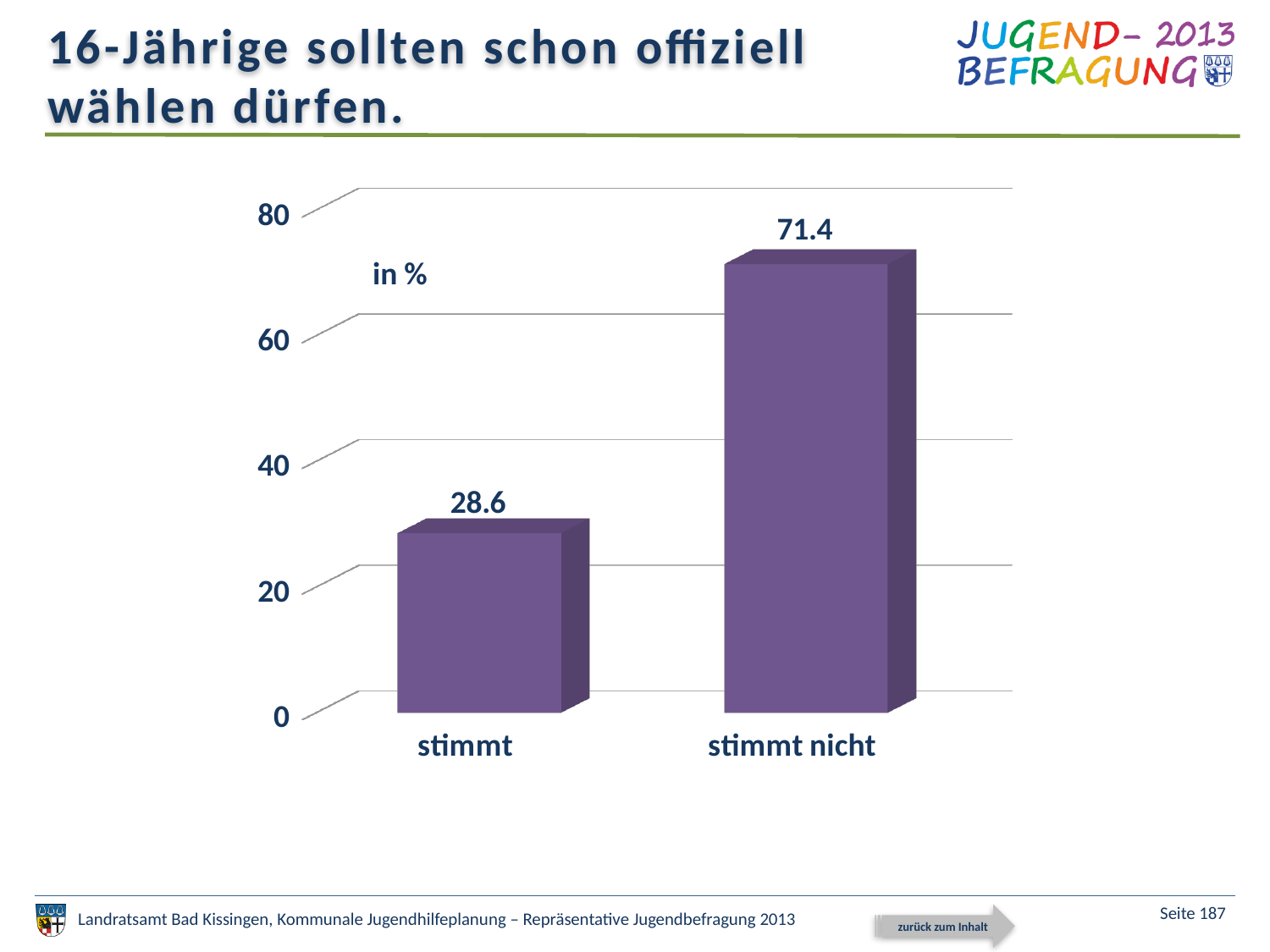
Which category has the highest value? stimmt nicht Is the value for "stimmt" greater or less than 40? less What kind of chart is shown on the slide? bar chart Is the value for "stimmt nicht" greater or less than 60? greater How many categories are shown on the x axis? 2 What is the value for "stimmt"? 28.6 What is the highest value shown on the y axis? 80 What is the difference between the values for "stimmt nicht" and "stimmt"? 42.8 What unit is indicated for the values in the chart? in % What is the value for "stimmt nicht"? 71.4 Which category has the lowest value? stimmt Which is larger, the value for "stimmt" or the value for "stimmt nicht"? stimmt nicht